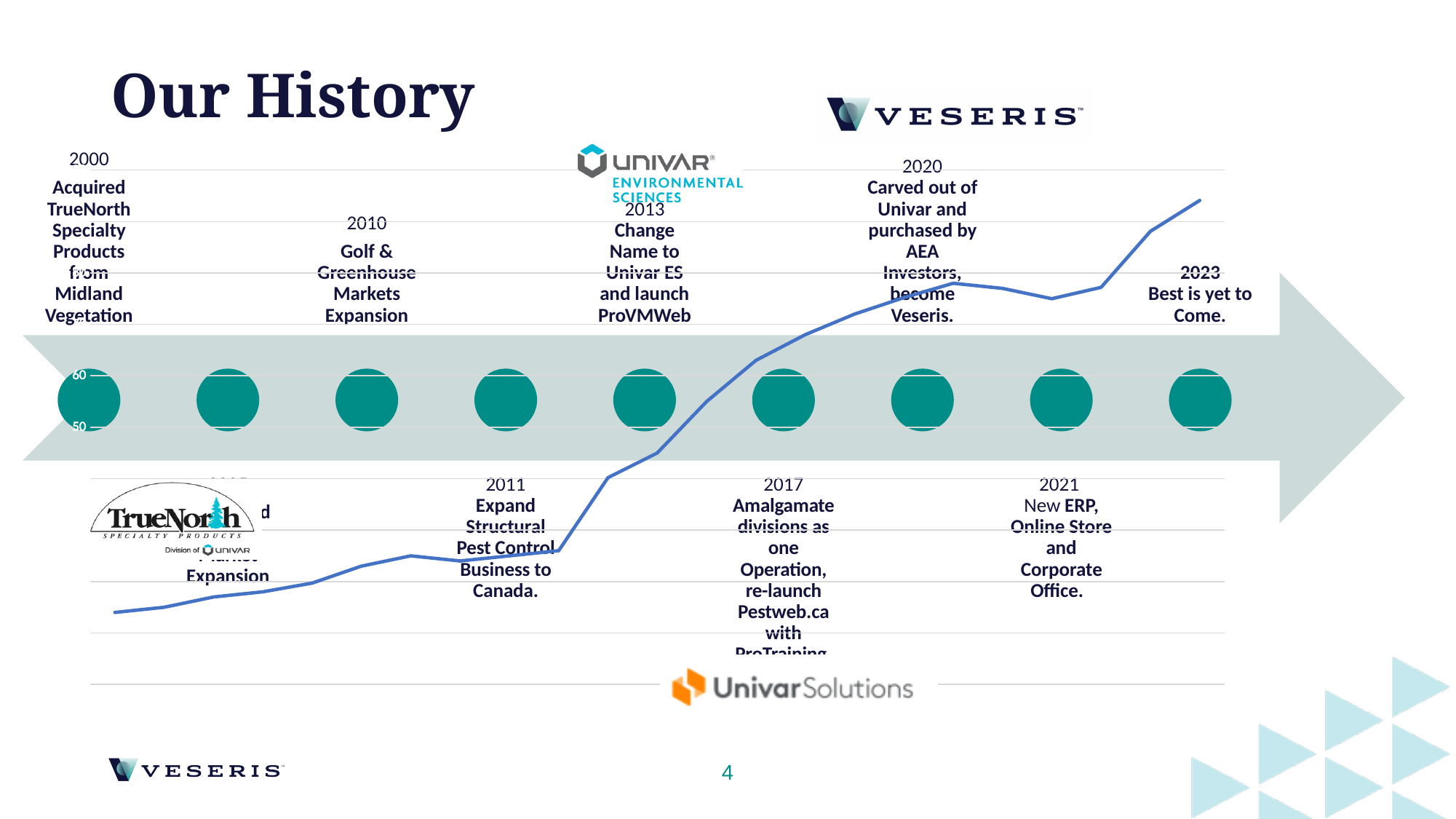
What kind of chart is overlaid on the timeline on this slide? line chart What colour is the plotted line in the chart? blue Do the values of the blue line rise or fall moving from left to right along the x axis? rise Is the value at the right end of the blue line greater or less than 60? greater Does the line chart display a legend? No How many data series are plotted in the line chart? 1 Is the value at the left end of the blue line greater or less than 50? less At which end of the x axis does the blue line reach its highest value? the right end At which end of the x axis does the blue line reach its lowest value? the left end